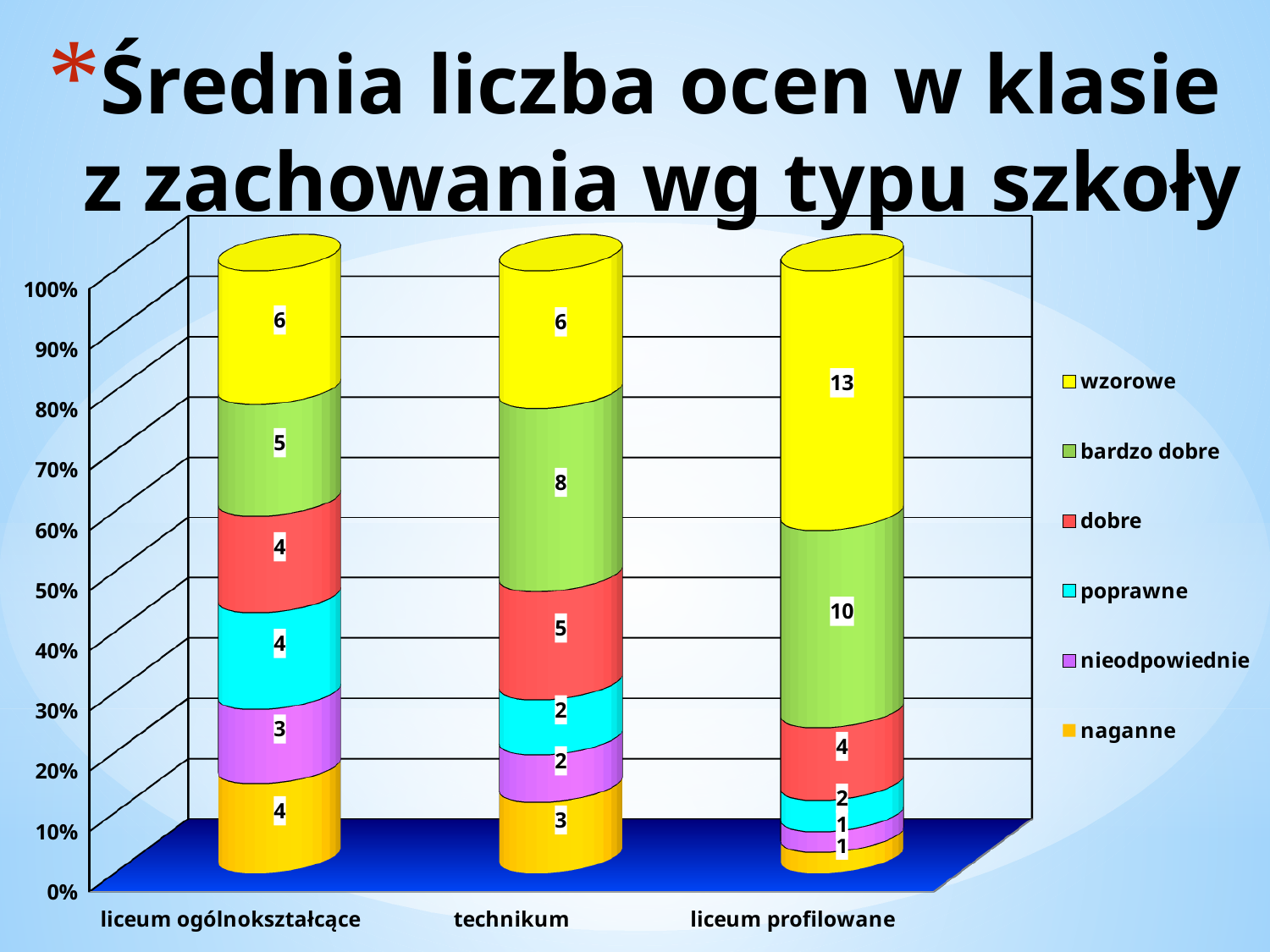
Which school type has the lowest nieodpowiednie value? liceum profilowane What is the value of the wzorowe segment for liceum profilowane? 13 What kind of chart is shown on the slide? stacked bar chart What is the value of the naganne segment for liceum ogólnokształcące? 4 Which school type has the highest wzorowe value? liceum profilowane How many series does the legend list? 6 How many school types are shown on the x axis? 3 What is the difference between the bardzo dobre values for liceum profilowane and liceum ogólnokształcące? 5 What is the value of the poprawne segment for technikum? 2 What is the total of all segments in the technikum bar? 26 What is the value of the bardzo dobre segment for technikum? 8 Which is larger: the dobre value for technikum or the dobre value for liceum profilowane? technikum